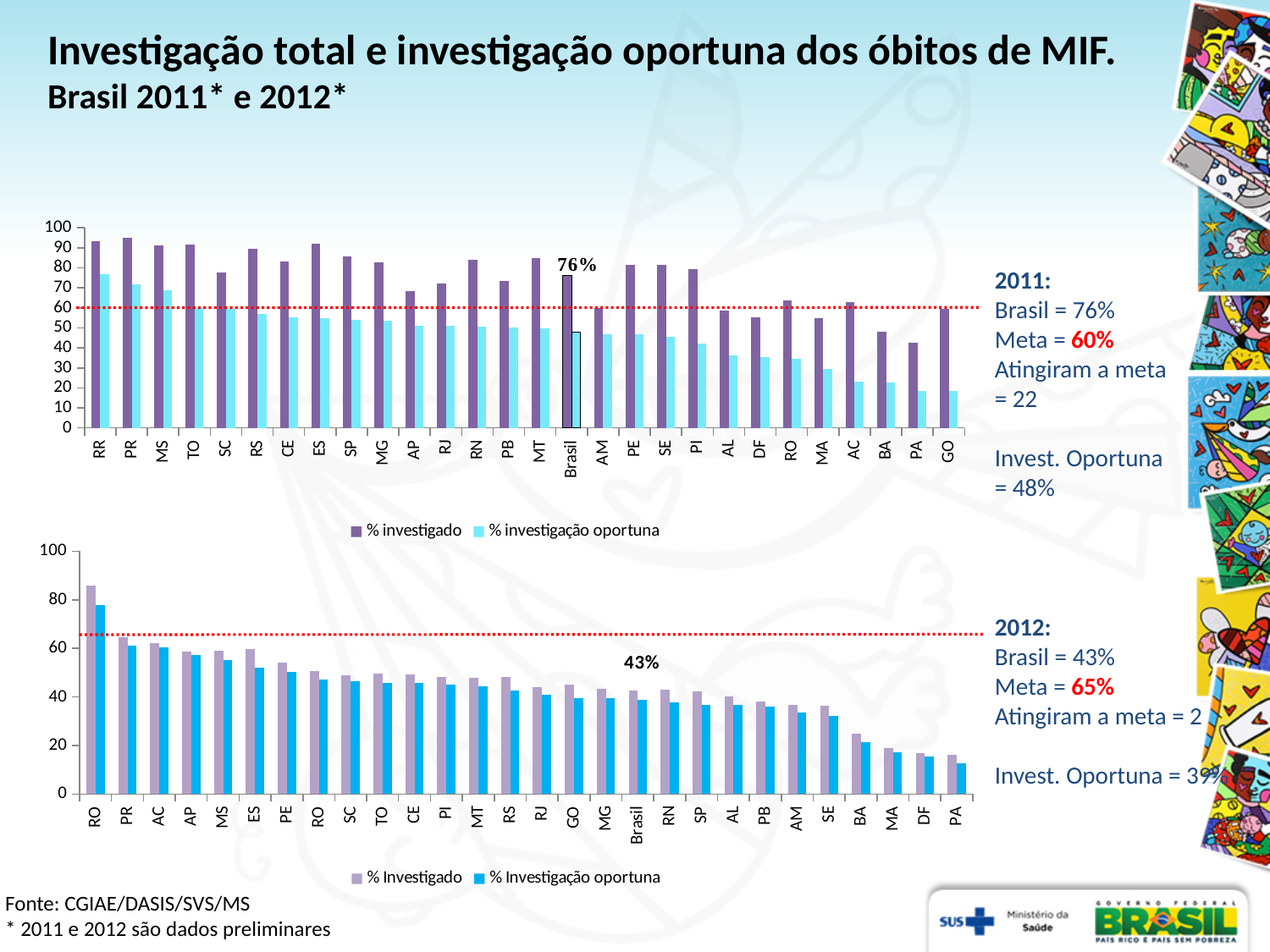
In the bottom chart (2012), do the % Investigado values rise or fall from left to right along the x axis? fall In the top chart (2011), is the % investigado value for PA greater or less than 50? less How many series does the legend of the top chart list? 2 What are the two legend entries of the bottom chart? % Investigado and % Investigação oportuna In the top chart (2011), which category has the lowest % investigado bar? PA In the bottom chart (2012), which category has the highest % Investigado bar? RO How many categories are shown on the x axis of the top chart? 28 In the bottom chart (2012), which has the larger % Investigado value, RO or PA? RO In the top chart (2011), is the % investigado value for RR greater or less than 80? greater In the top chart (2011), what is the % investigado value shown for Brasil? 76% In the bottom chart (2012), what is the % Investigado value shown for Brasil? 43% What kind of chart is the top chart on the slide? bar chart